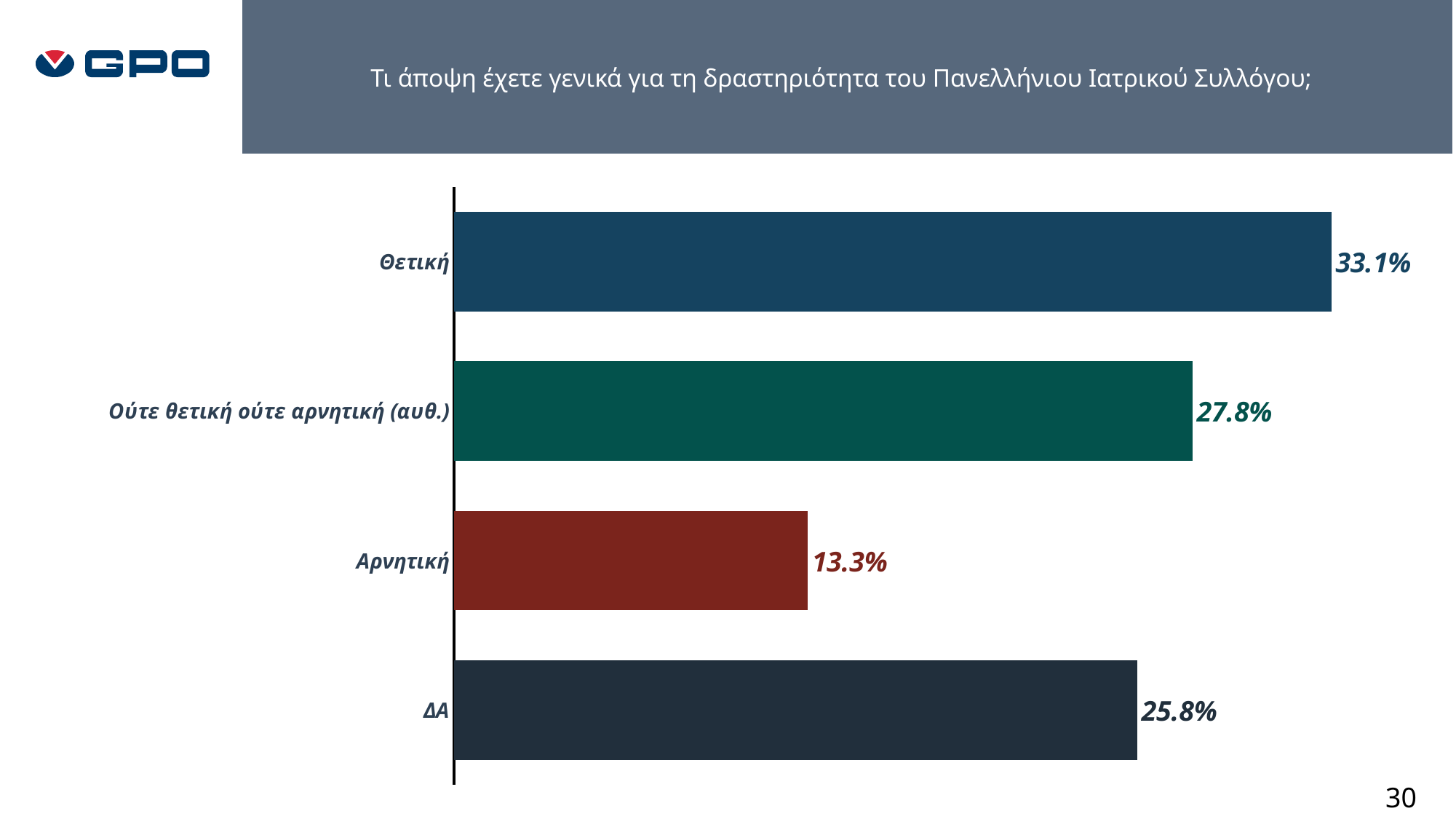
What colour is the bar for Αρνητική? dark red What is the difference between the values for Θετική and Αρνητική? 19.8% What is the value for Θετική? 33.1% Which category has the lowest value? Αρνητική What is the value for Αρνητική? 13.3% What is the difference between the values for Ούτε θετική ούτε αρνητική (αυθ.) and ΔΑ? 2.0% What kind of chart is shown on the slide? bar chart What is the value for Ούτε θετική ούτε αρνητική (αυθ.)? 27.8% Which is larger, the value for ΔΑ or the value for Αρνητική? ΔΑ Which category has the highest value? Θετική What is the value for ΔΑ? 25.8% How many categories are shown in the chart? 4